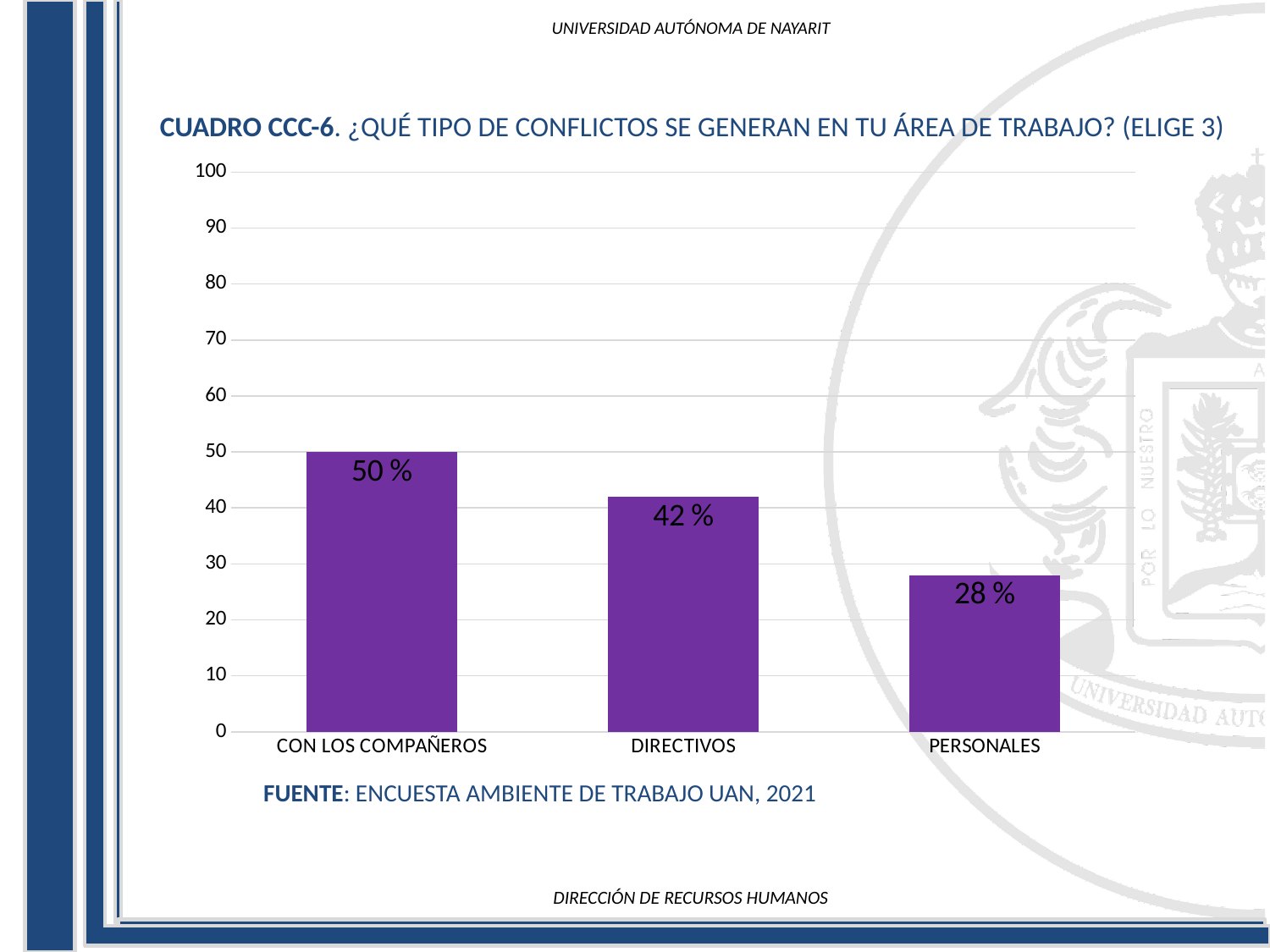
What is the difference between the values for CON LOS COMPAÑEROS and PERSONALES? 22 % What is the value for DIRECTIVOS? 42 % What is the value for CON LOS COMPAÑEROS? 50 % Which is larger, the value for DIRECTIVOS or the value for PERSONALES? DIRECTIVOS Do the values rise or fall from left to right across the categories? fall Is the value for DIRECTIVOS greater or less than 40? greater Which category has the highest value? CON LOS COMPAÑEROS What is the value for PERSONALES? 28 % Which category has the lowest value? PERSONALES How many categories are shown in the chart? 3 What is the difference between the values for DIRECTIVOS and PERSONALES? 14 % What kind of chart is shown on the slide? bar chart